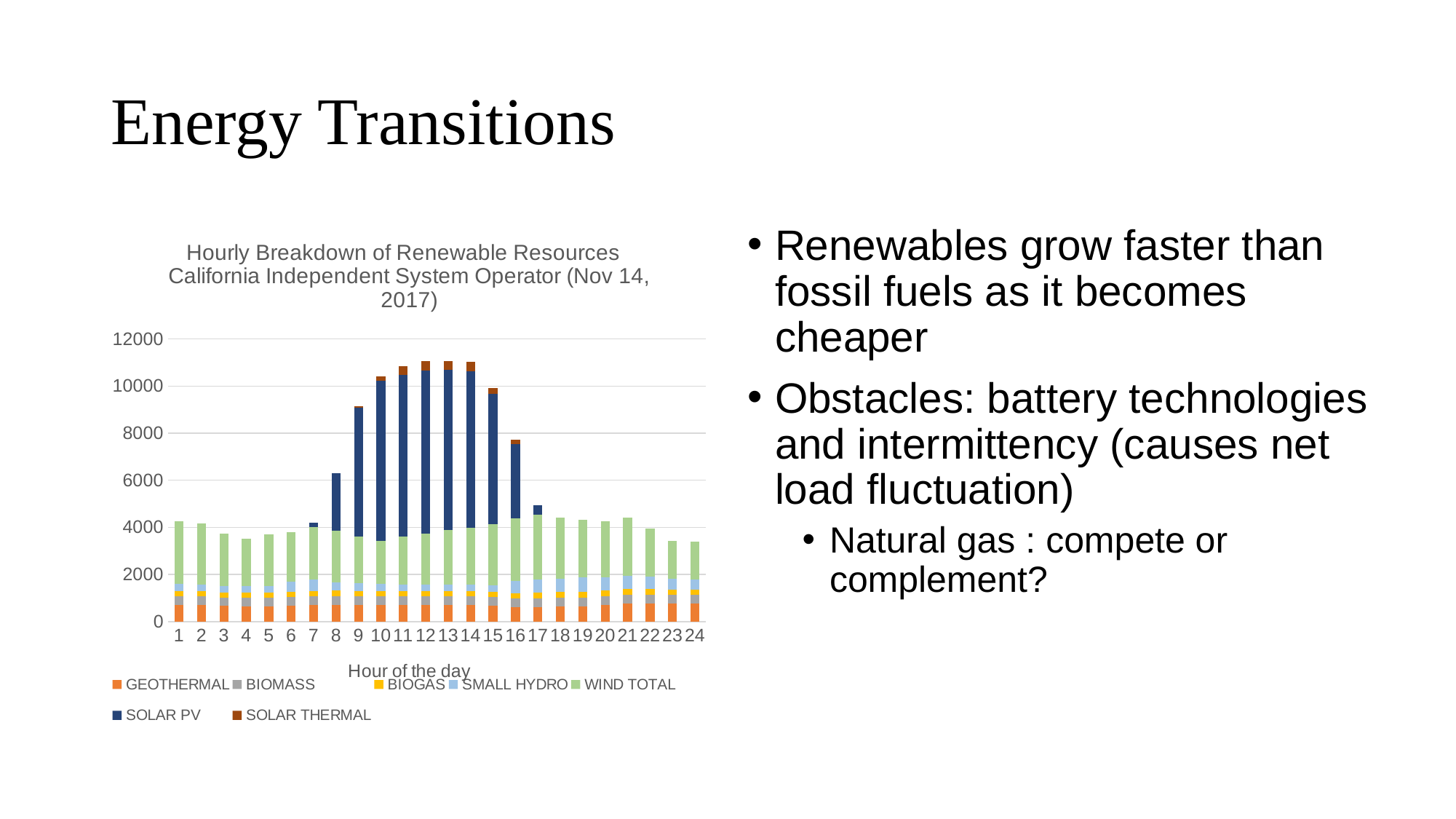
Is the total stacked value for hour 12 greater or less than 10000? greater Which has the larger total stacked value, hour 7 or hour 8? Hour 8 How many hours (bars) are plotted along the x axis of the chart? 24 Is the total stacked value for hour 9 greater or less than 8000? greater Do the total stacked values rise or fall from hour 14 to hour 17? Fall What is the label of the x axis of the chart? Hour of the day How many series does the chart's legend list? 7 What kind of chart is shown on the slide? Stacked bar chart Is the total stacked value for hour 4 greater or less than 4000? less Which has the larger total stacked value, hour 12 or hour 1? Hour 12 Which series is shown in dark blue in the chart's legend? SOLAR PV